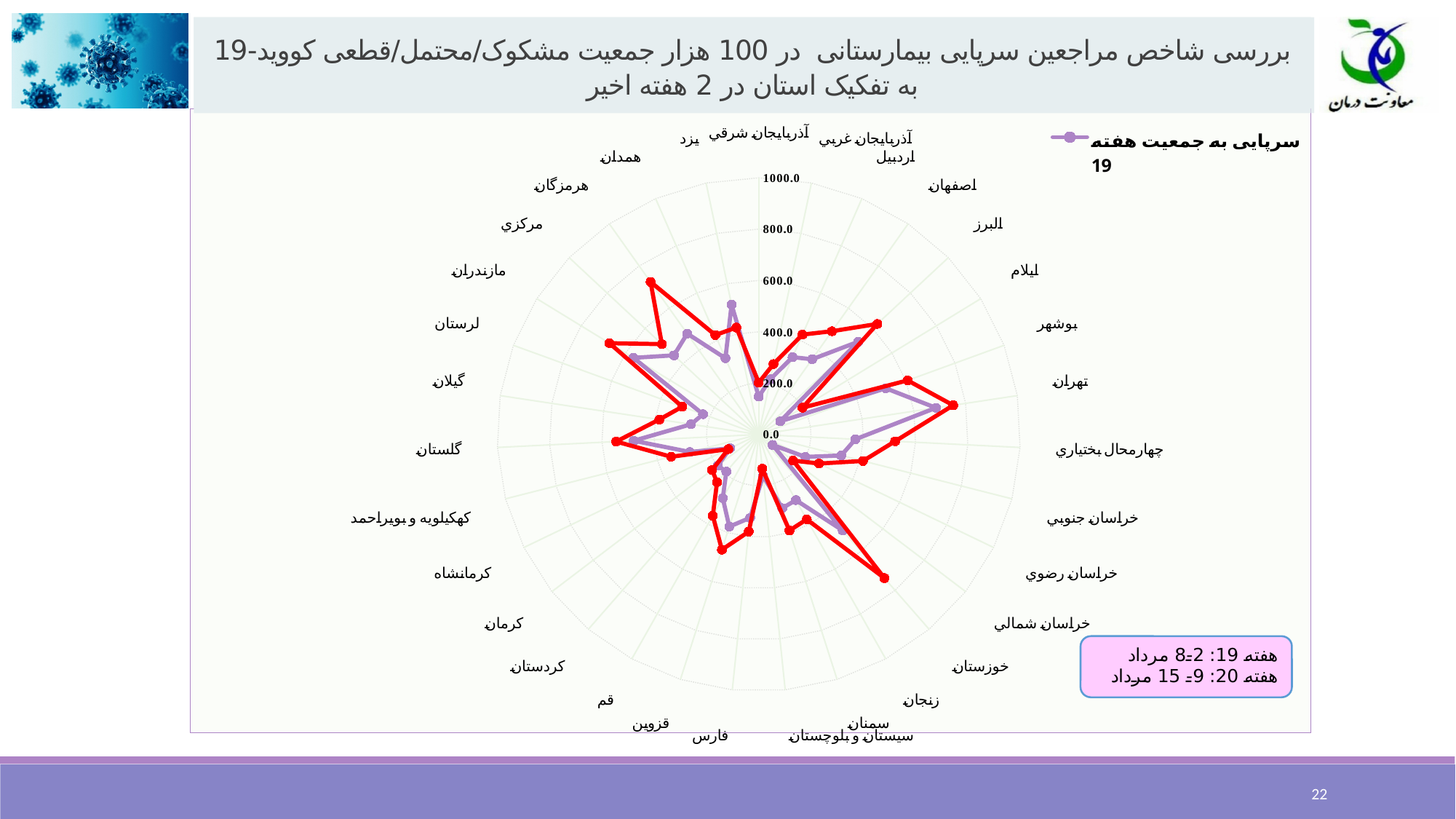
What series name is shown in the chart legend? سرپایی به جمعیت هفته 19 What is the highest value labelled on the radial axis of the chart? 1000.0 Is the red series value for تهران greater or less than 600? greater What kind of chart is shown on the slide? radar chart How many provinces (categories) are plotted around the radar chart? 31 Is the purple series value for تهران greater or less than 400? greater Is the purple series value for آذربايجان شرقي greater or less than 800? less